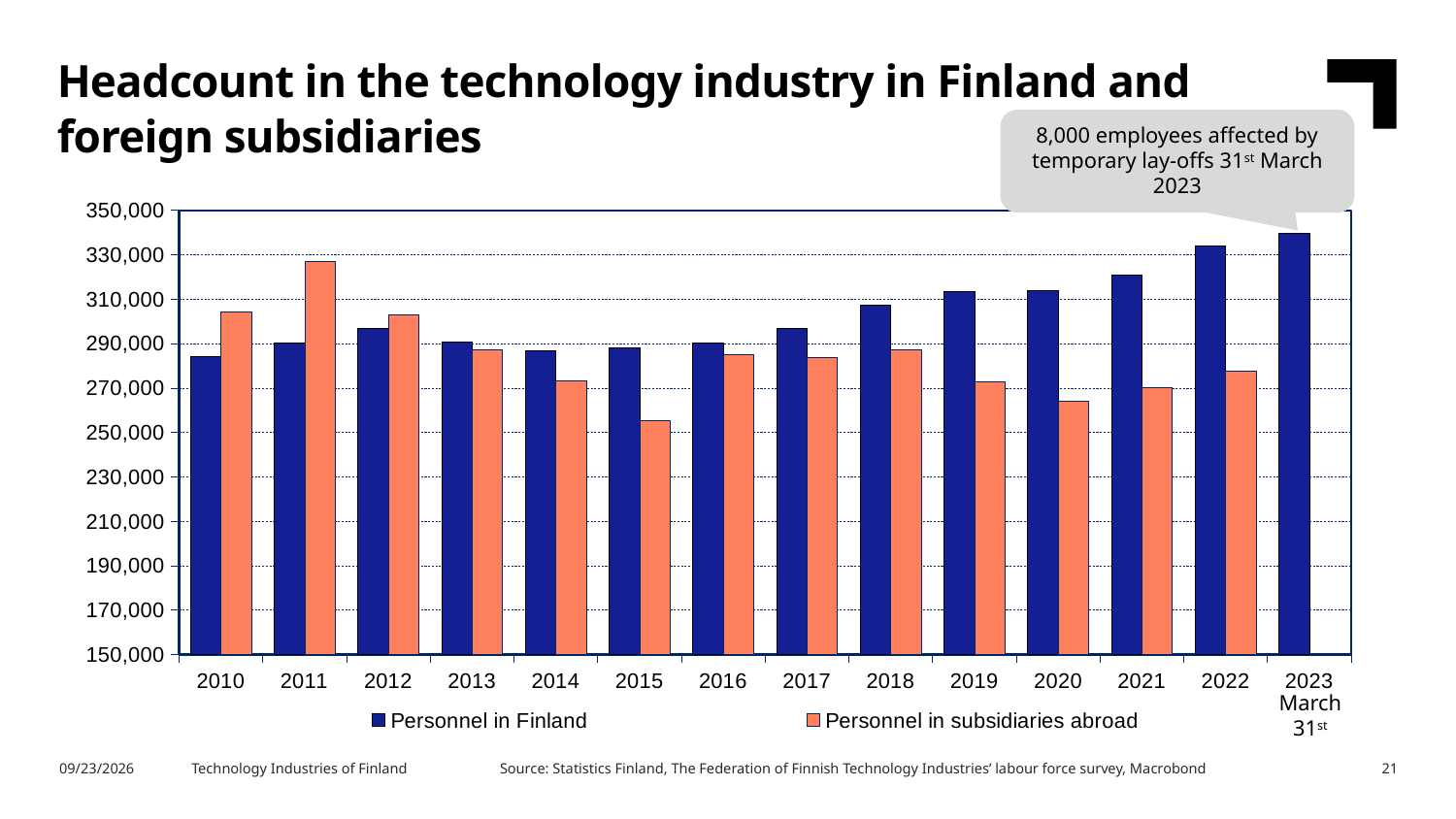
What kind of chart is shown on the slide? bar chart How many series does the legend list? 2 Does Personnel in Finland rise or fall from 2016 to 2023 March 31st? rise In 2010, which is larger: Personnel in Finland or Personnel in subsidiaries abroad? Personnel in subsidiaries abroad In which year is Personnel in Finland highest? 2023 March 31st How many years (categories) are shown on the x axis? 14 Is the value for Personnel in subsidiaries abroad in 2015 greater or less than 270,000? less In which year is Personnel in subsidiaries abroad lowest? 2015 Is the value for Personnel in Finland in 2023 March 31st greater or less than 330,000? greater In 2020, which is larger: Personnel in Finland or Personnel in subsidiaries abroad? Personnel in Finland In which year is Personnel in subsidiaries abroad highest? 2011 Is the value for Personnel in Finland in 2010 greater or less than 290,000? less